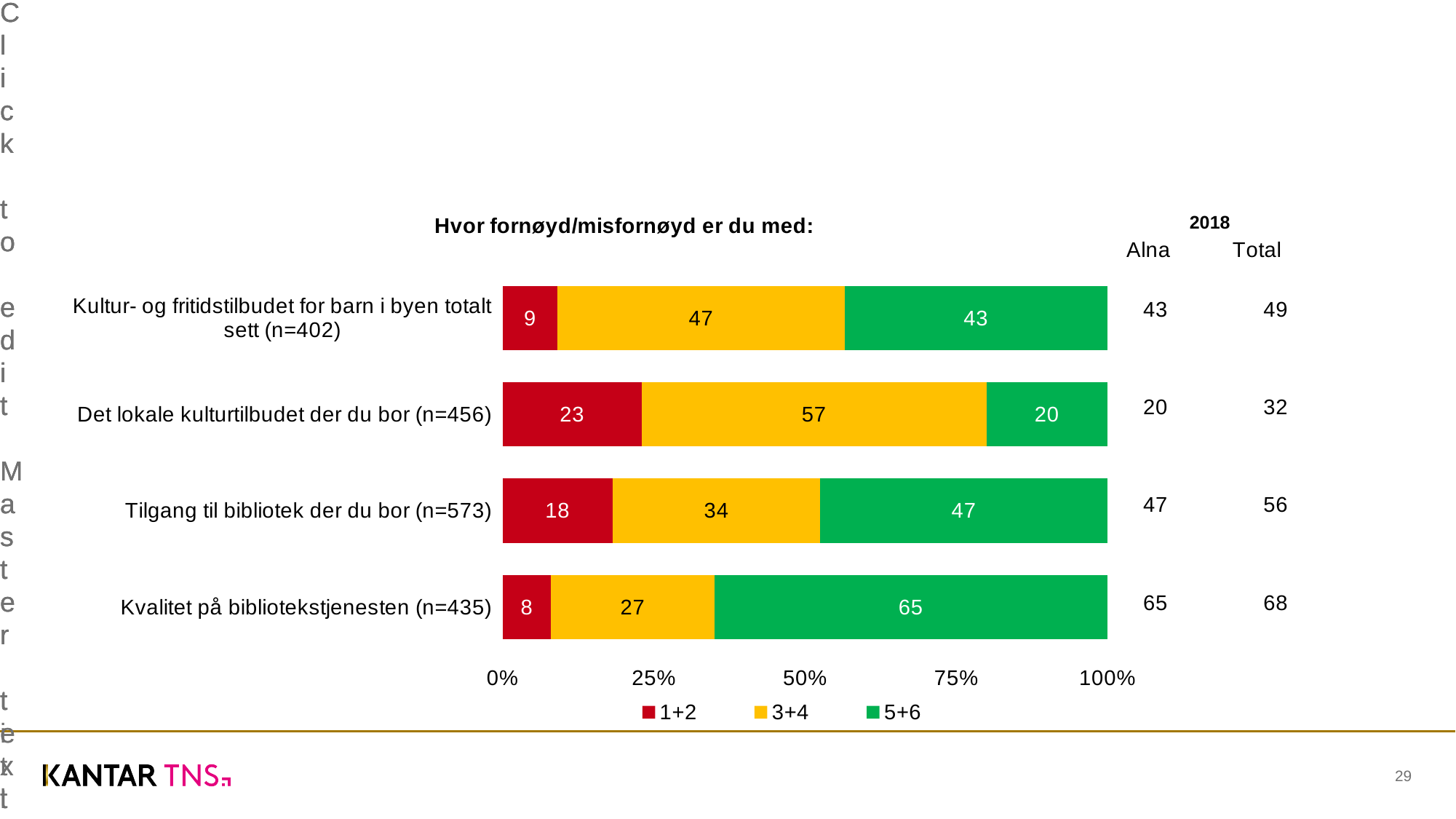
Which category has the lowest 1+2 value? Kvalitet på bibliotekstjenesten (n=435) How many series does the legend list? 3 What is the 3+4 value for "Tilgang til bibliotek der du bor (n=573)"? 34 What is the title of the chart? Hvor fornøyd/misfornøyd er du med: Which category has the highest 5+6 value? Kvalitet på bibliotekstjenesten (n=435) What is the 5+6 value for "Kvalitet på bibliotekstjenesten (n=435)"? 65 What is the 1+2 value for "Det lokale kulturtilbudet der du bor (n=456)"? 23 What kind of chart is shown on the slide? Stacked bar chart Which is larger: the 5+6 value for "Tilgang til bibliotek der du bor (n=573)" or for "Det lokale kulturtilbudet der du bor (n=456)"? Tilgang til bibliotek der du bor (n=573) What is the difference between the 3+4 values for "Det lokale kulturtilbudet der du bor (n=456)" and "Kvalitet på bibliotekstjenesten (n=435)"? 30 How many categories are plotted in the chart? 4 What is the total of the stacked bar for "Kultur- og fritidstilbudet for barn i byen totalt sett (n=402)"? 99